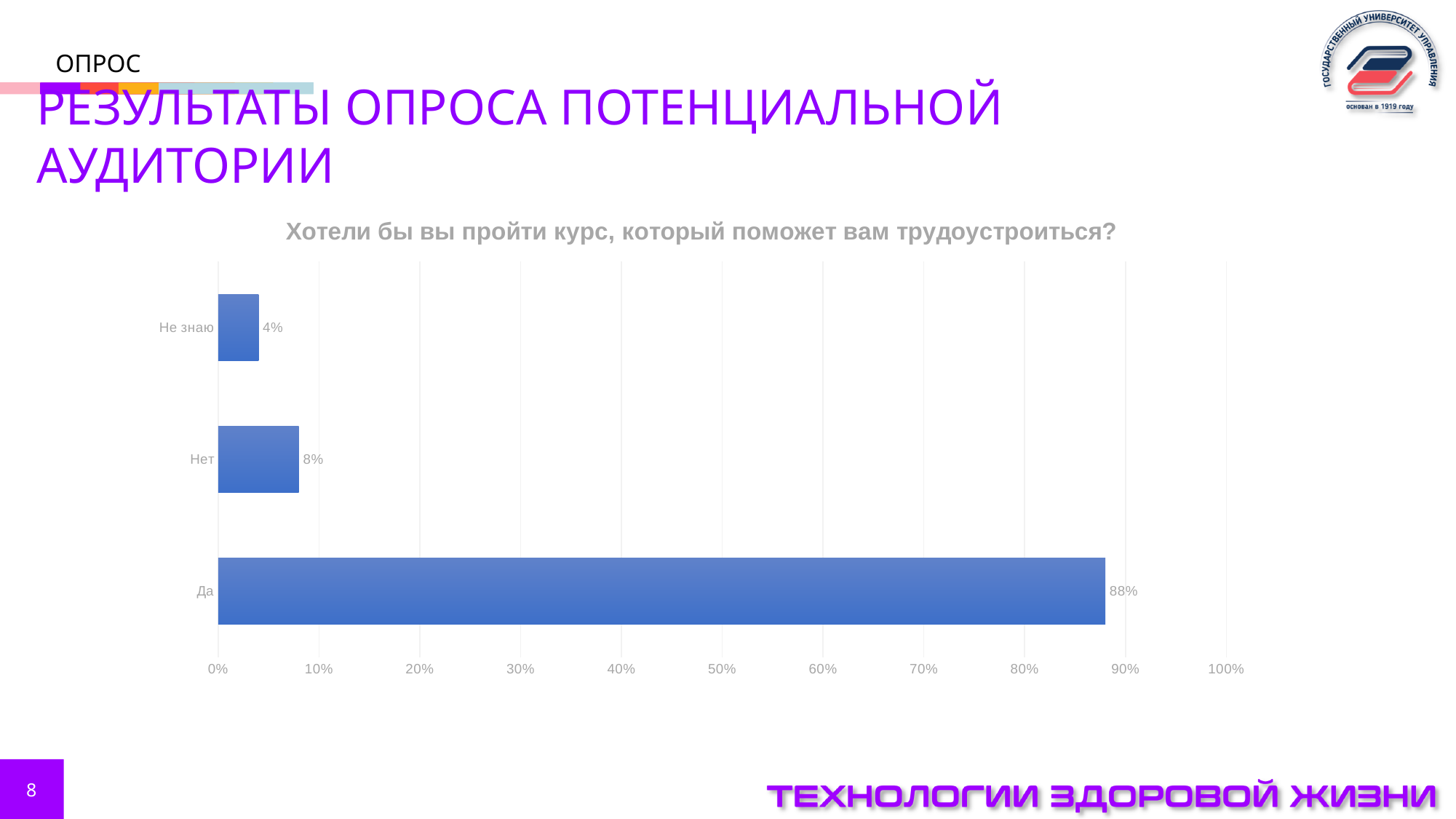
What is the difference between the values for "Да" and "Нет"? 80% What percentage of respondents answered "Не знаю"? 4% What percentage of respondents answered "Нет"? 8% Is the value for "Да" greater or less than 80%? greater What is the title of the chart? Хотели бы вы пройти курс, который поможет вам трудоустроиться? What is the difference between the values for "Нет" and "Не знаю"? 4% Which answer category has the lowest value? Не знаю Which is larger, the value for "Нет" or the value for "Не знаю"? Нет What percentage of respondents answered "Да"? 88% How many answer categories are shown in the chart? 3 Which answer category has the highest value? Да What kind of chart is shown on the slide? Bar chart